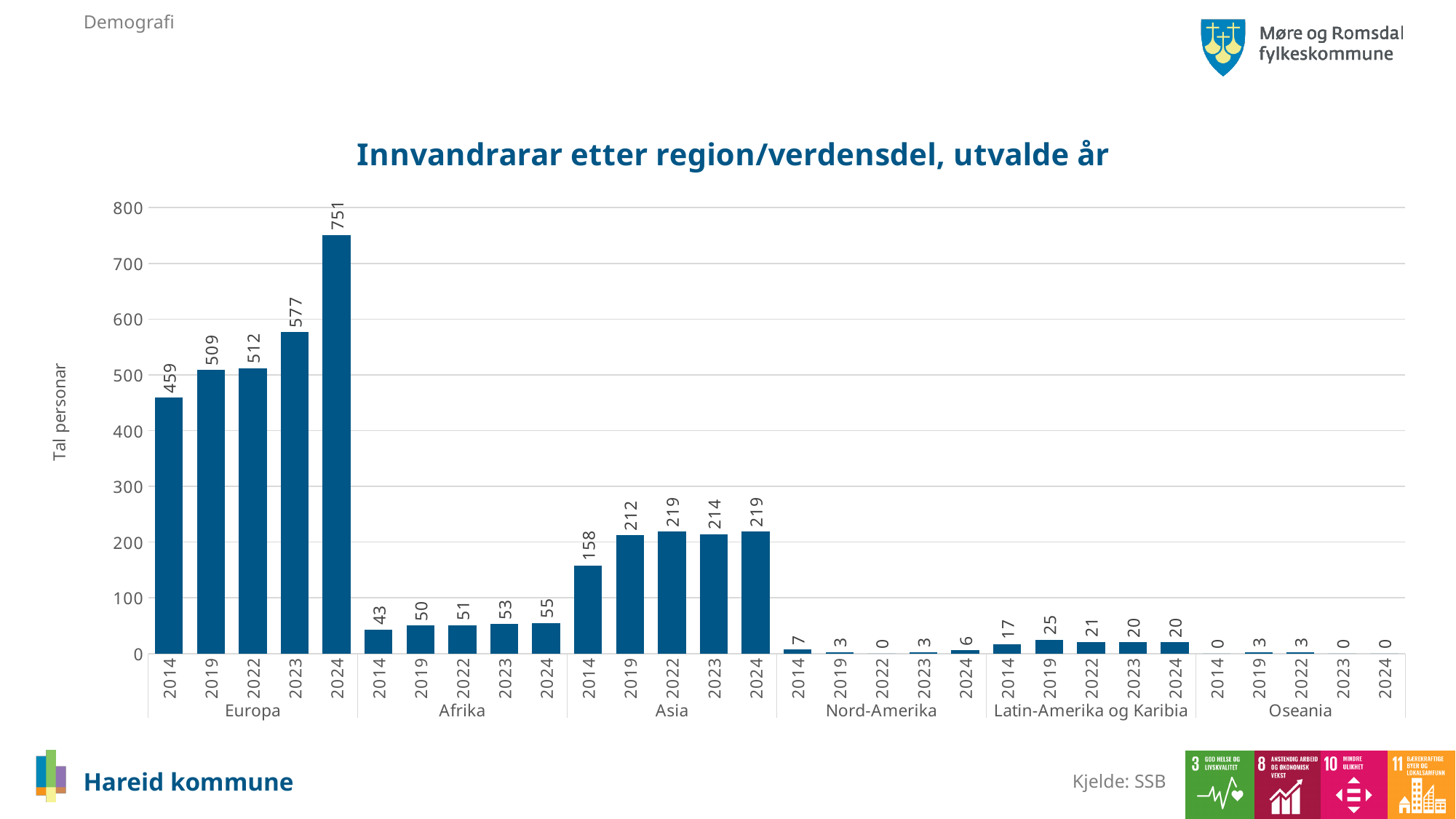
What is the difference between the Europa values for 2024 and 2023? 174 Which region and year has the highest bar in the chart? Europa 2024 What is the value for Asia in 2014? 158 Which is larger, the value for Afrika in 2024 or the value for Latin-Amerika og Karibia in 2024? Afrika in 2024 Do the Europa values rise or fall from 2014 to 2024? rise What is the value for Europa in 2024? 751 What is the difference between the Asia values for 2019 and 2014? 54 What is the title of the chart? Innvandrarar etter region/verdensdel, utvalde år What is the value for Afrika in 2019? 50 How many regions are shown on the x axis? 6 What is the value for Latin-Amerika og Karibia in 2019? 25 Is the value for Europa in 2014 greater or less than 400? greater